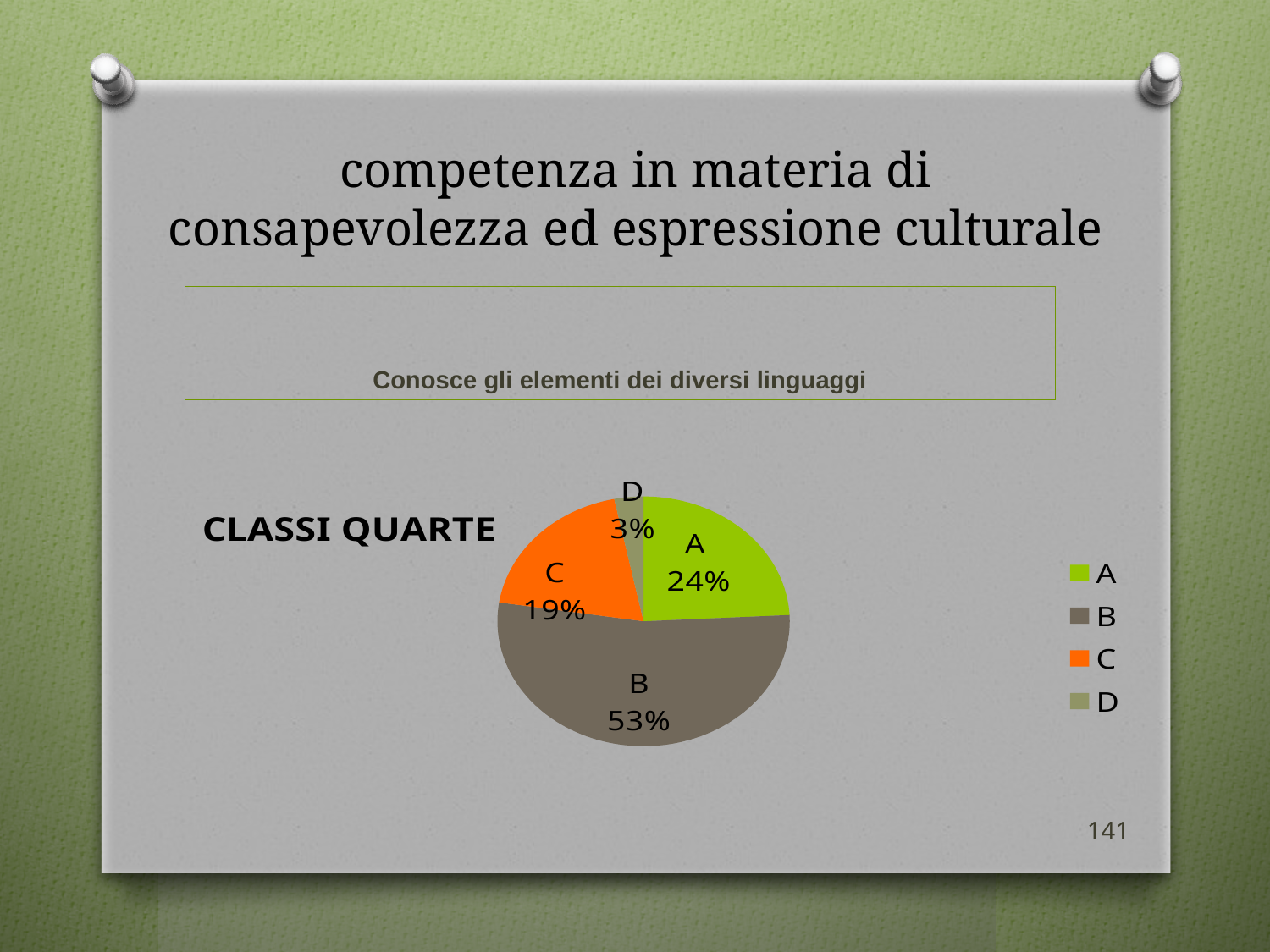
What colour is the slice for category C? orange What share of the pie does category B have? 53% Which category has the smallest slice of the pie? D What share of the pie does category A have? 24% How many categories are shown in the pie chart? 4 How many entries does the legend list? 4 What share of the pie does category D have? 3% What kind of chart is shown on the slide? pie chart What is the difference in percentage points between category B and category A? 29 Which is larger, the share for A or the share for C? A Which category has the largest slice of the pie? B